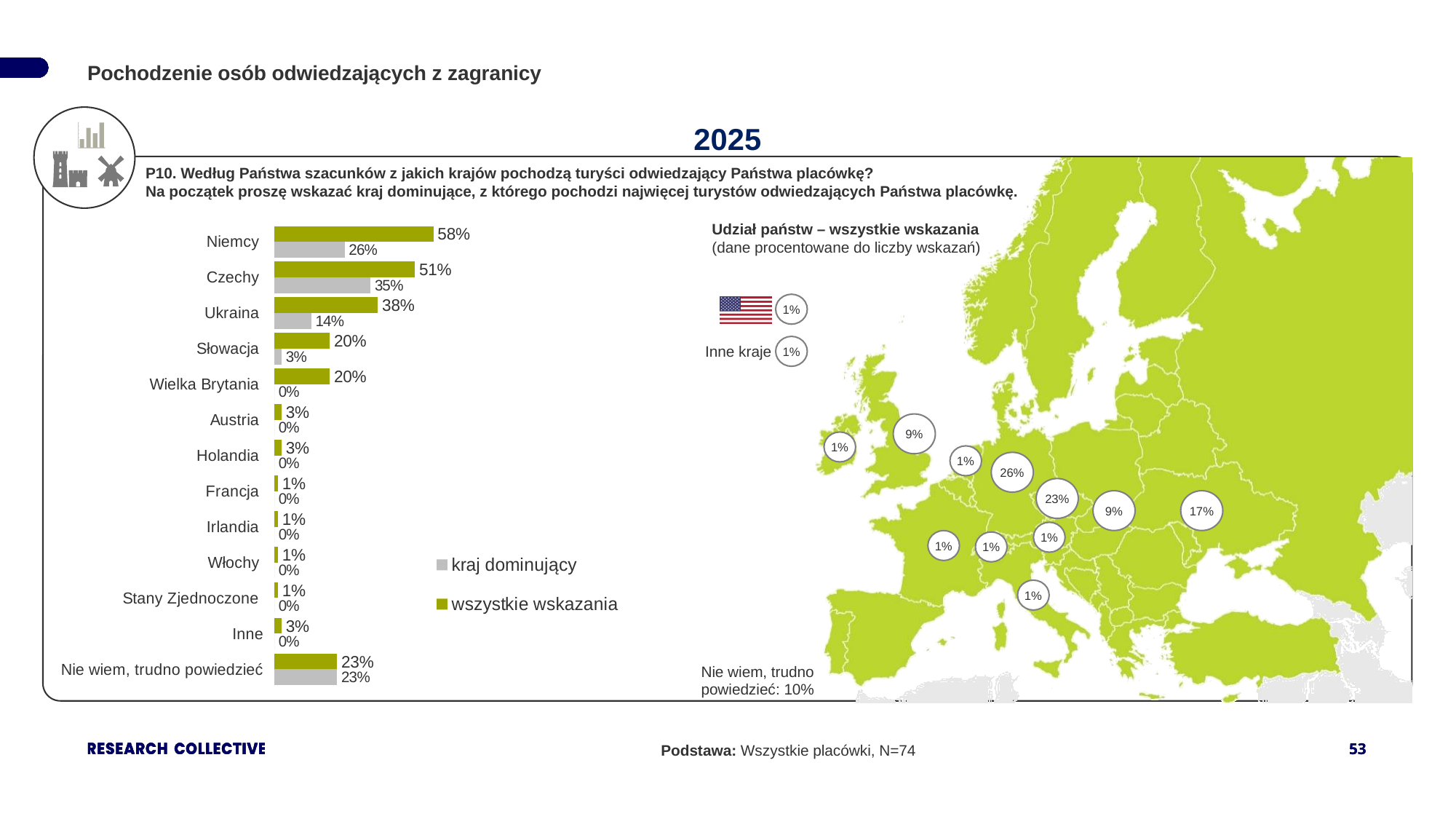
In the bar chart, what is the value of 'wszystkie wskazania' for Niemcy? 58% In the bar chart, what is the value of 'kraj dominujący' for Czechy? 35% What type of chart is used on the left side of the slide? Bar chart In the bar chart, what is the difference between the 'wszystkie wskazania' and 'kraj dominujący' values for Niemcy? 32% In the bar chart, what is the value of 'kraj dominujący' for Ukraina? 14% Which series in the bar chart is shown in grey? kraj dominujący How many series does the bar chart legend list? 2 In the bar chart, what is the value of 'kraj dominujący' for Słowacja? 3% In the bar chart, which category has the highest value for 'wszystkie wskazania'? Niemcy In the bar chart, which is larger: the 'wszystkie wskazania' value for Czechy or for Ukraina? Czechy How many categories are shown in the bar chart? 13 In the bar chart, what is the value of 'wszystkie wskazania' for 'Nie wiem, trudno powiedzieć'? 23%